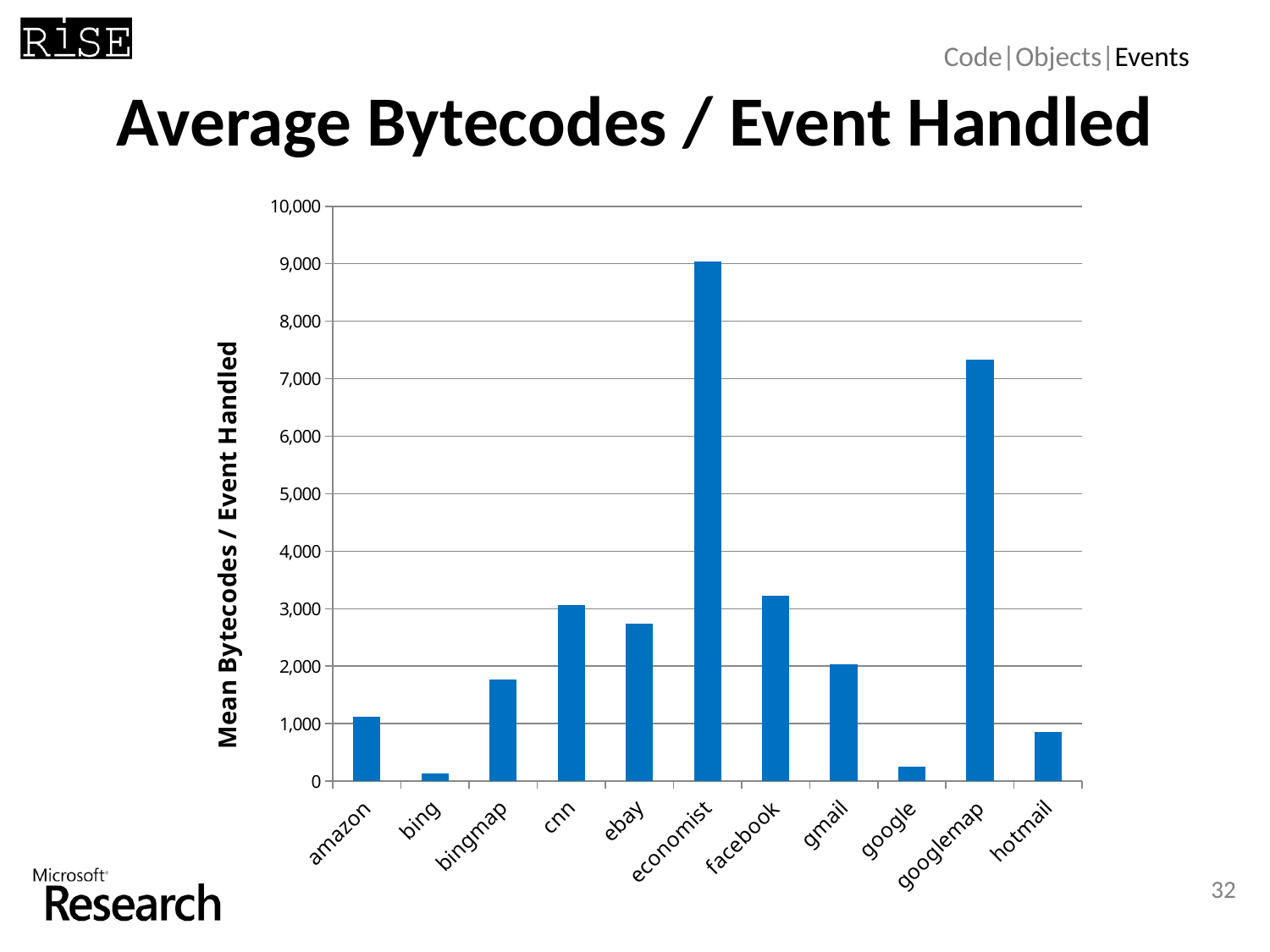
Is the value for hotmail greater or less than 1,000? less How many websites are shown on the x axis of the chart? 11 Is the value for amazon greater or less than 1,000? greater What is the label on the vertical axis of the chart? Mean Bytecodes / Event Handled Which website has the lowest mean bytecodes per event handled? bing Which website has the highest mean bytecodes per event handled? economist Which has a higher mean bytecodes per event handled, googlemap or economist? economist Is the value for ebay greater or less than 3,000? less What kind of chart is shown on the slide? bar chart Which has a higher mean bytecodes per event handled, ebay or gmail? ebay